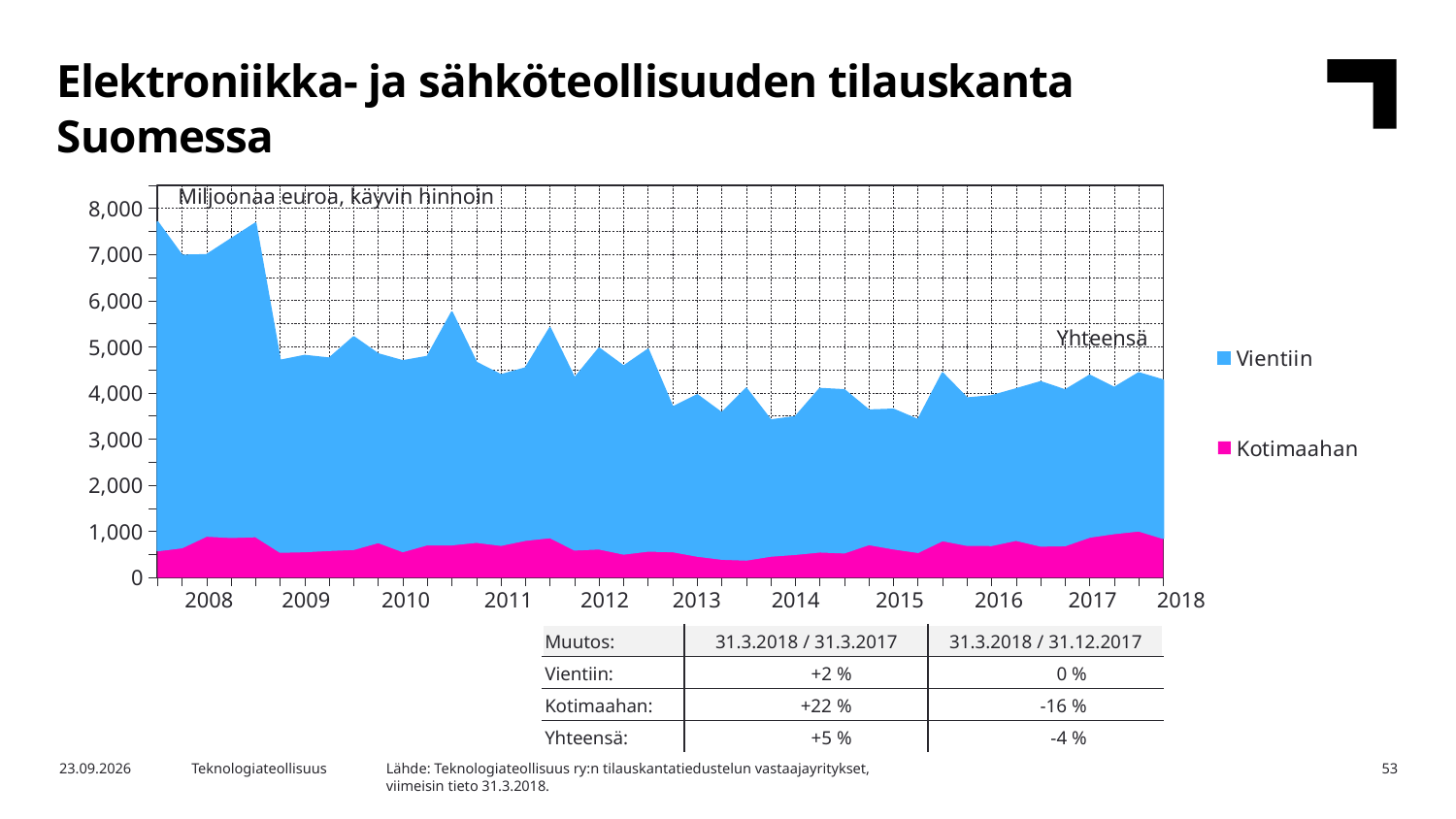
What kind of chart is shown on the slide? Area chart Is the Kotimaahan value in 2014 greater or less than 1,000? less What unit label is printed at the top of the chart? Miljoonaa euroa, käyvin hinnoin In which year shown on the x axis does the total (Yhteensä) reach its highest level? 2008 Which series, Vientiin or Kotimaahan, has the larger values throughout the chart? Vientiin Is the total (Yhteensä) value in 2010 greater or less than 4,000? greater Is the total (Yhteensä) value at the start of 2018 greater or less than 5,000? less Which is larger, the total value at the start of 2008 or at the start of 2018? 2008 What are the two series named in the chart legend? Vientiin and Kotimaahan Does the total order backlog (Yhteensä) generally rise or fall from 2008 to 2018? fall How many series does the chart legend list? 2